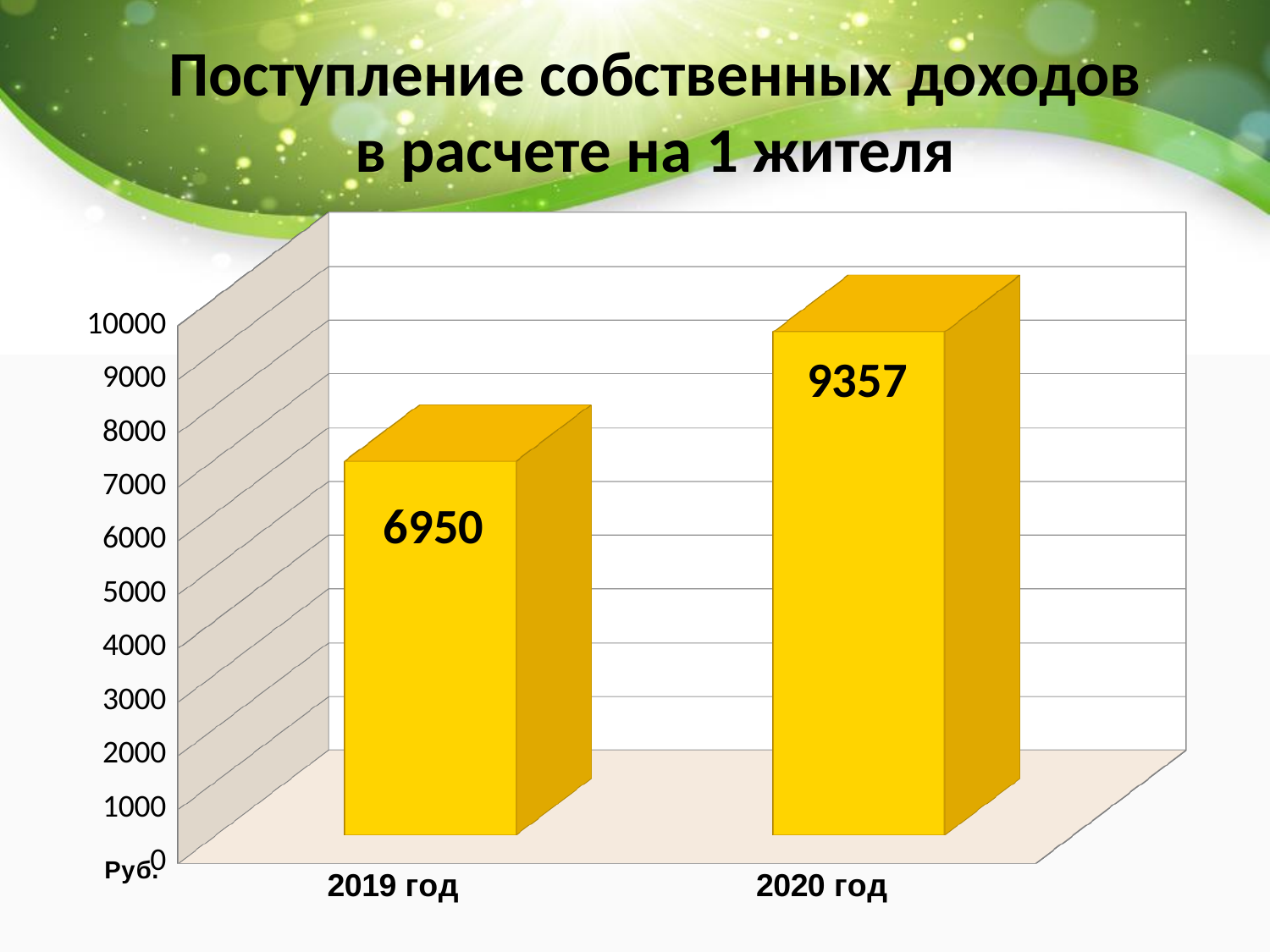
Which year has the highest value? 2020 год How many categories are shown on the x axis? 2 What is the difference between the values for 2020 год and 2019 год? 2407 Is the value for 2019 год greater or less than 7000? less What is the value for 2019 год? 6950 What kind of chart is shown on the slide? bar chart Do the values rise or fall from 2019 год to 2020 год? rise Is the value for 2020 год greater or less than 9000? greater What is the value for 2020 год? 9357 What is the title of the chart? Поступление собственных доходов в расчете на 1 жителя Which is larger, the value for 2019 год or the value for 2020 год? 2020 год Which year has the lowest value? 2019 год